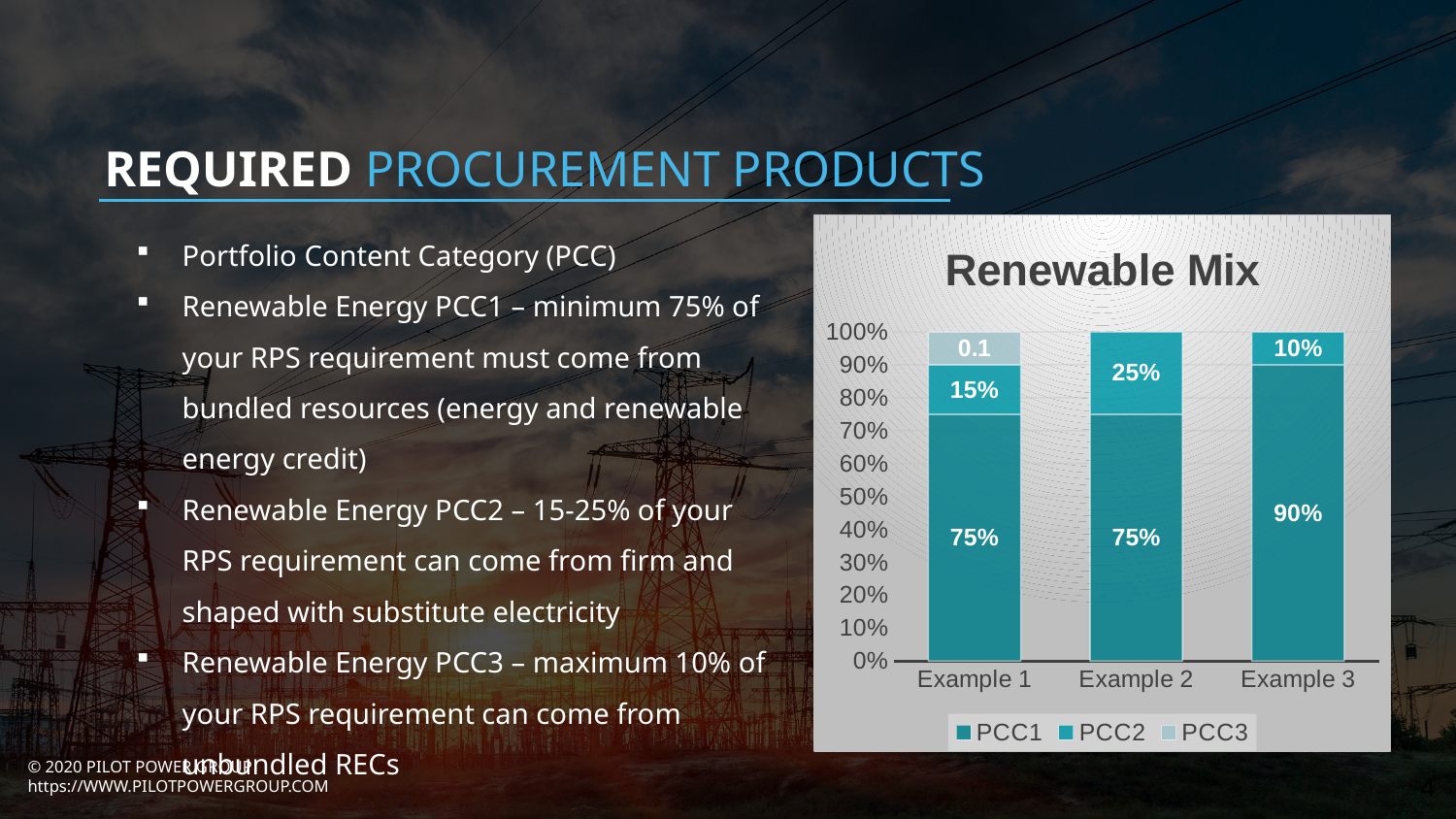
What type of chart is shown on the slide? stacked bar chart What is the PCC2 value for Example 2? 25% What is the difference between the PCC2 values for Example 2 and Example 1? 10% What is the total of the stacked bar for Example 3? 100% How many categories are shown on the x axis? 3 What is the title of the chart? Renewable Mix What is the PCC3 label shown for Example 1? 0.1 Is the PCC2 value for Example 2 larger than the PCC2 value for Example 1? Yes What is the PCC1 value for Example 3? 90% What is the PCC2 value for Example 1? 15% Which category has the highest PCC1 value? Example 3 How many series does the legend list? 3